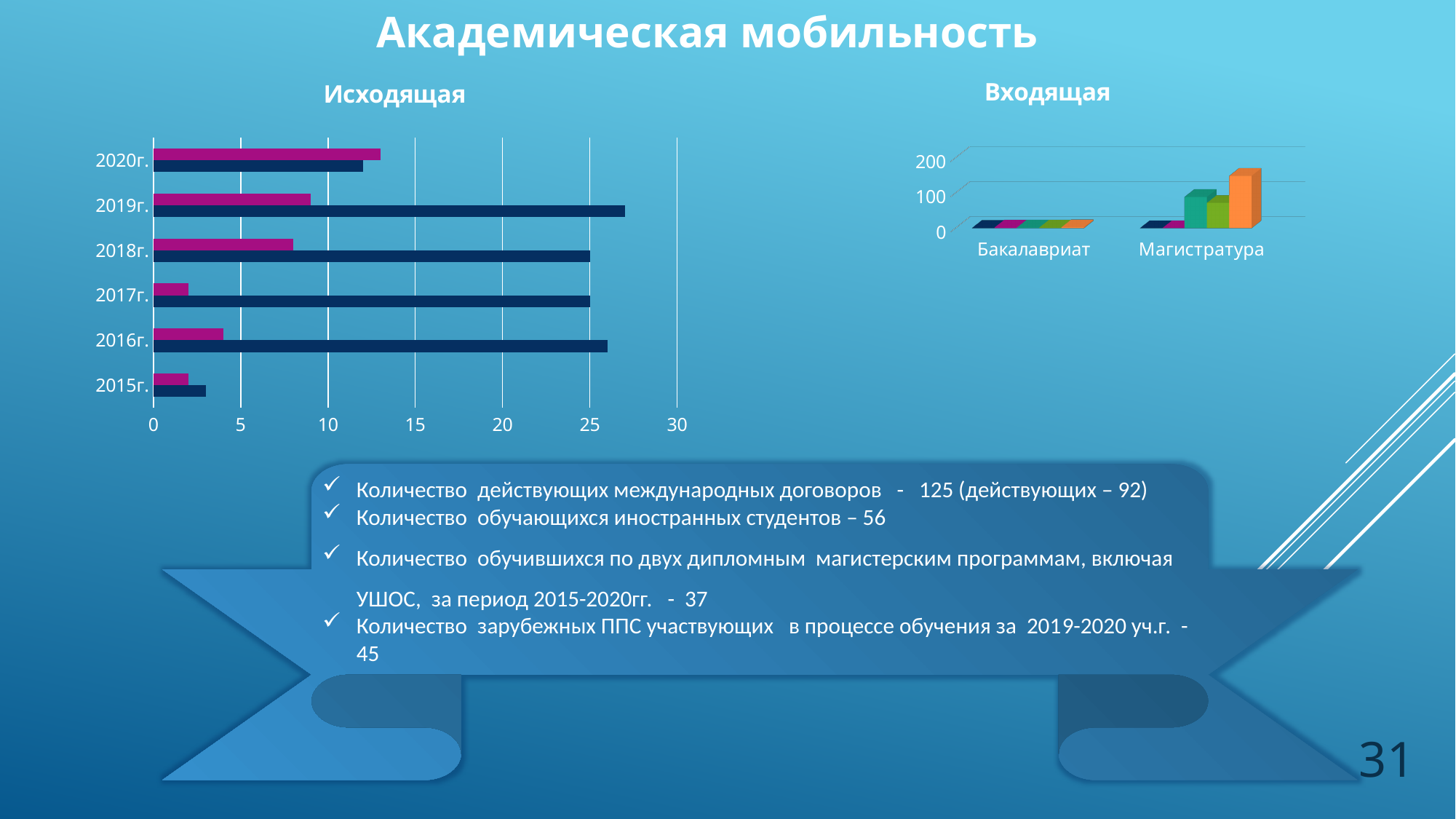
On the 'Исходящая' chart, is the dark blue bar for 2019г. greater or less than 25? greater On the 'Исходящая' chart, which dark blue bar is longer: 2019г. or 2020г.? 2019г. On the 'Исходящая' chart, is the magenta bar for 2020г. greater or less than 10? greater What kind of chart is the 'Исходящая' chart on the left? bar chart What is the highest value labelled on the vertical axis of the 'Входящая' chart? 200 How many categories are shown on the 'Входящая' chart? 2 On the 'Исходящая' chart, do the magenta bars rise or fall from 2017г. to 2020г.? rise On the 'Входящая' chart, which category has the taller bars: Бакалавриат or Магистратура? Магистратура On the 'Исходящая' chart, which year has the shortest dark blue bar? 2015г. On the 'Исходящая' chart, is the dark blue bar for 2015г. greater or less than 5? less How many years are shown on the 'Исходящая' chart? 6